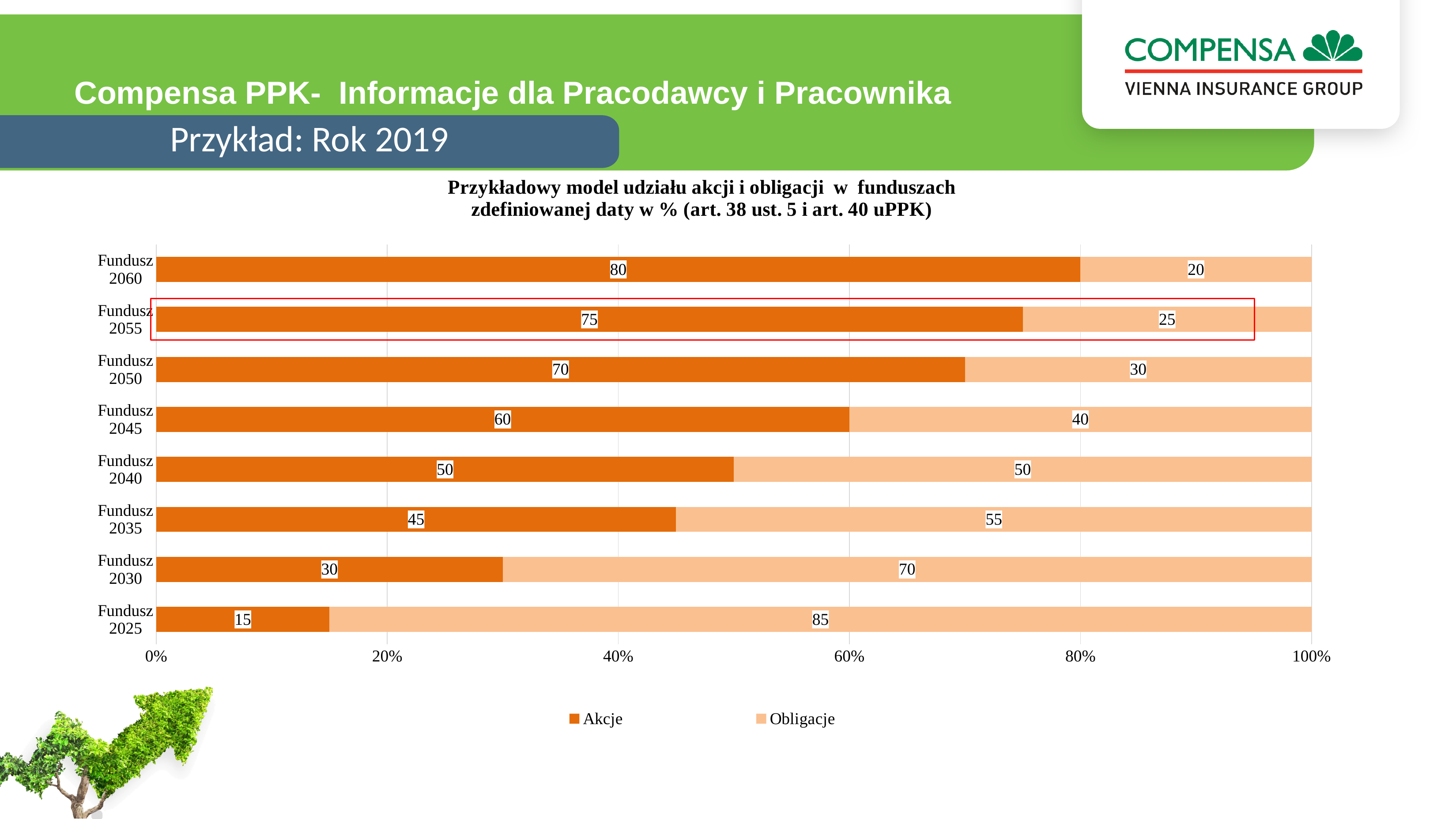
How many series does the legend list? 2 Which is larger, the Obligacje value for Fundusz 2045 or for Fundusz 2055? Fundusz 2045 Which fund has the highest Akcje value? Fundusz 2060 What is the Obligacje value for Fundusz 2025? 85 What is the Akcje value for Fundusz 2060? 80 What is the Akcje value for Fundusz 2035? 45 What is the total of the stacked bar for Fundusz 2045? 100 Is the Akcje value for Fundusz 2040 greater or less than 40%? greater What is the difference between the Akcje values for Fundusz 2050 and Fundusz 2030? 40 Which fund has the lowest Obligacje value? Fundusz 2060 How many funds are shown on the chart? 8 What kind of chart is shown on the slide? Stacked bar chart